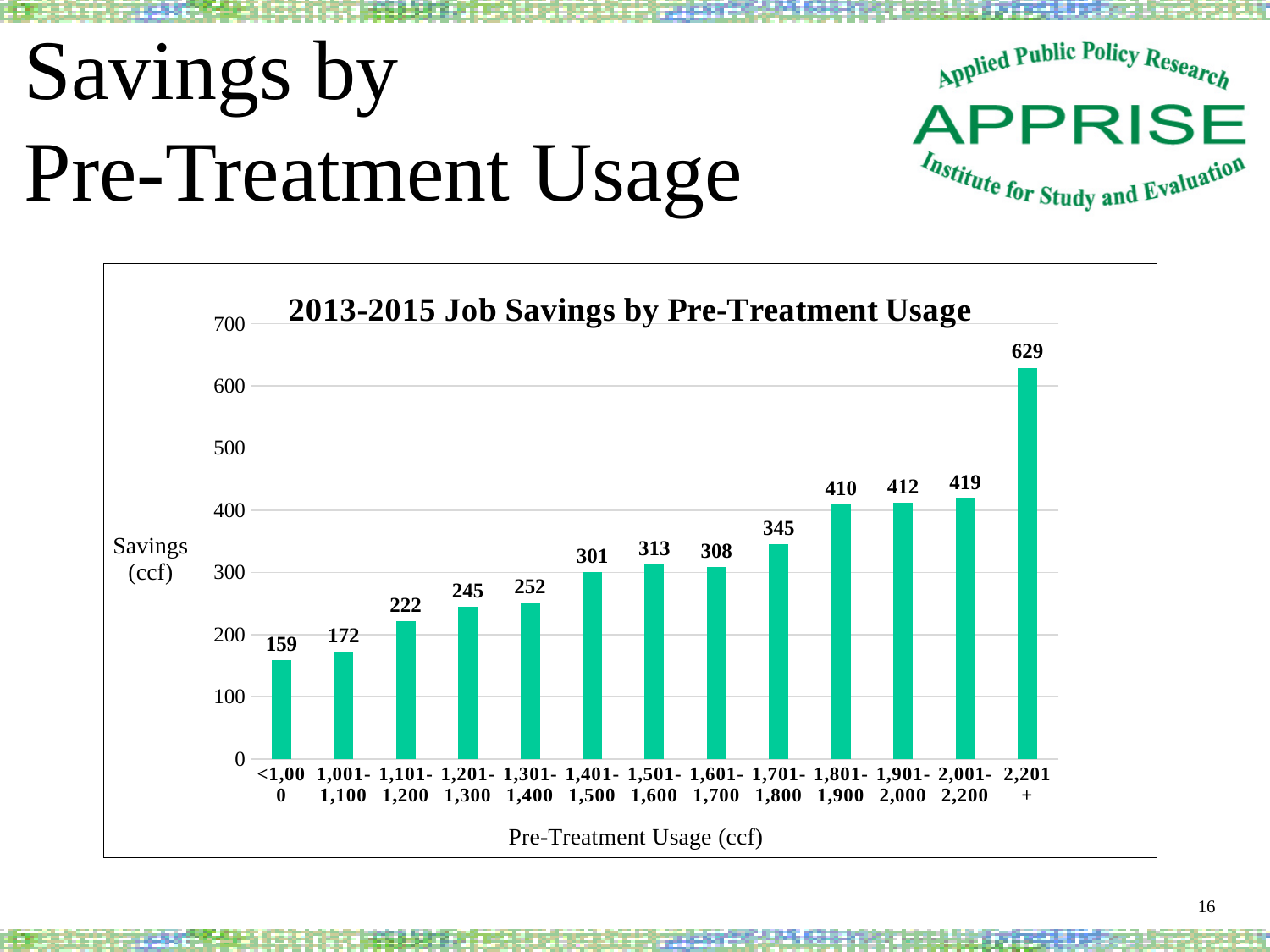
What is the title of the chart? 2013-2015 Job Savings by Pre-Treatment Usage What is the savings value for the <1,000 ccf pre-treatment usage group? 159 Which pre-treatment usage group has the lowest savings? <1,000 Which pre-treatment usage group has the highest savings? 2,201+ How many pre-treatment usage groups are shown on the chart? 13 What is the savings value for the 1,801-1,900 ccf group? 410 What is the difference in savings between the 1,701-1,800 group and the 1,601-1,700 group? 37 What is the difference in savings between the 2,201+ group and the 2,001-2,200 group? 210 What is the savings value for the 1,401-1,500 ccf pre-treatment usage group? 301 What type of chart is shown on the slide? bar chart Which has higher savings, the 1,501-1,600 group or the 1,601-1,700 group? 1,501-1,600 Is the savings value for the 1,301-1,400 group greater or less than 300? less